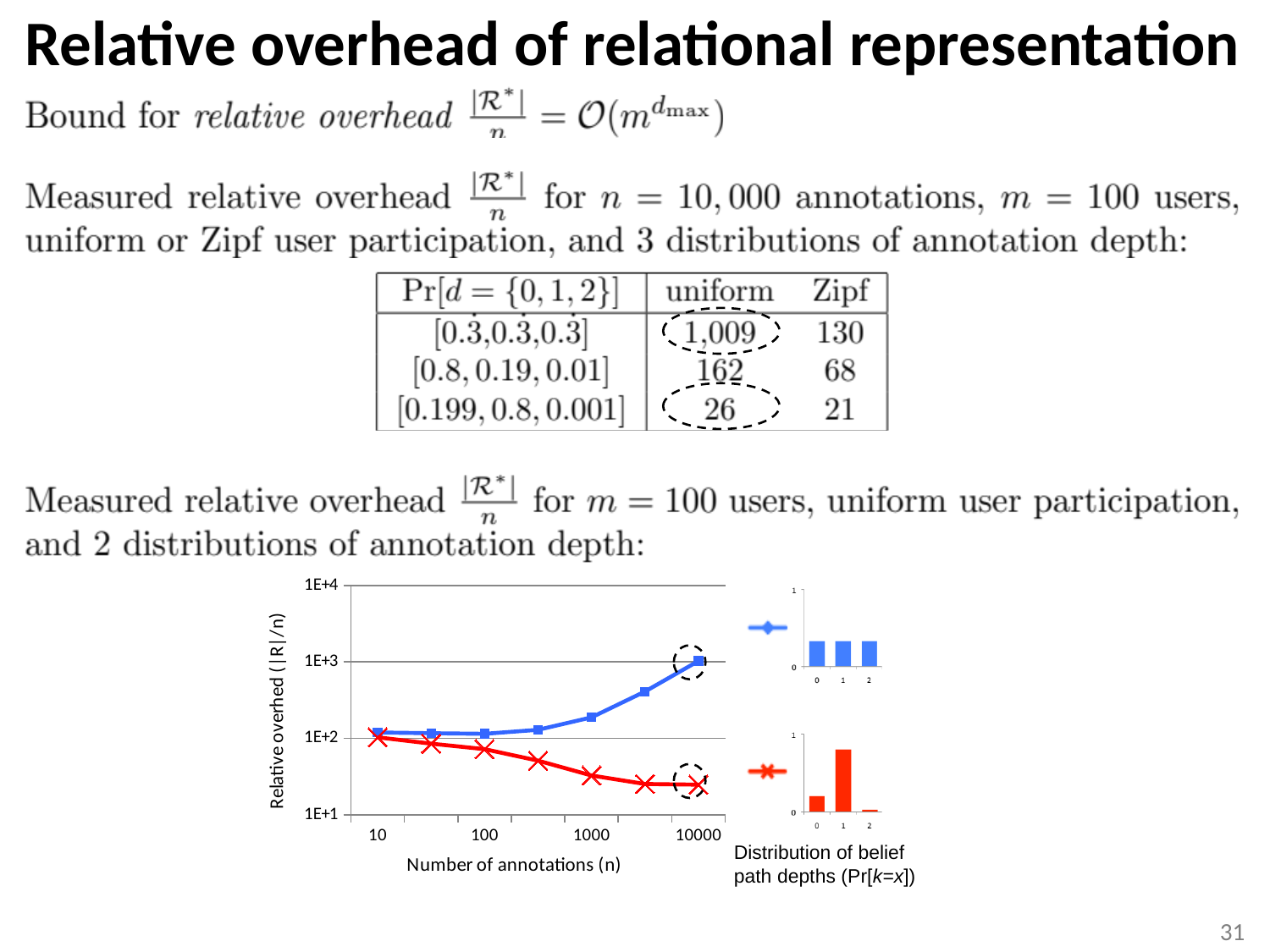
In the main line chart, is the value of the blue series at n = 10000 greater or less than 1E+2? greater In the main line chart, is the value of the red series at n = 10000 greater or less than 1E+2? less In the main line chart, does the blue series rise or fall as the number of annotations increases? rise What kind of chart is the main chart at the bottom of the slide (Relative overhead vs Number of annotations)? line chart In the main line chart, what is the label of the x axis? Number of annotations (n) In the small blue bar chart on the right (distribution of belief path depths), how many bars are shown? 3 In the main line chart, at n = 10000, which series has the larger value, blue or red? blue In the main line chart, does the red series rise or fall as the number of annotations increases? fall In the main line chart, how many series are plotted? 2 In the main line chart, what is the label of the y axis? Relative overhed ( |R|/n) In the main line chart, how many data points does the blue series have? 7 In the small red bar chart on the right (distribution of belief path depths), which depth has the highest bar? 1